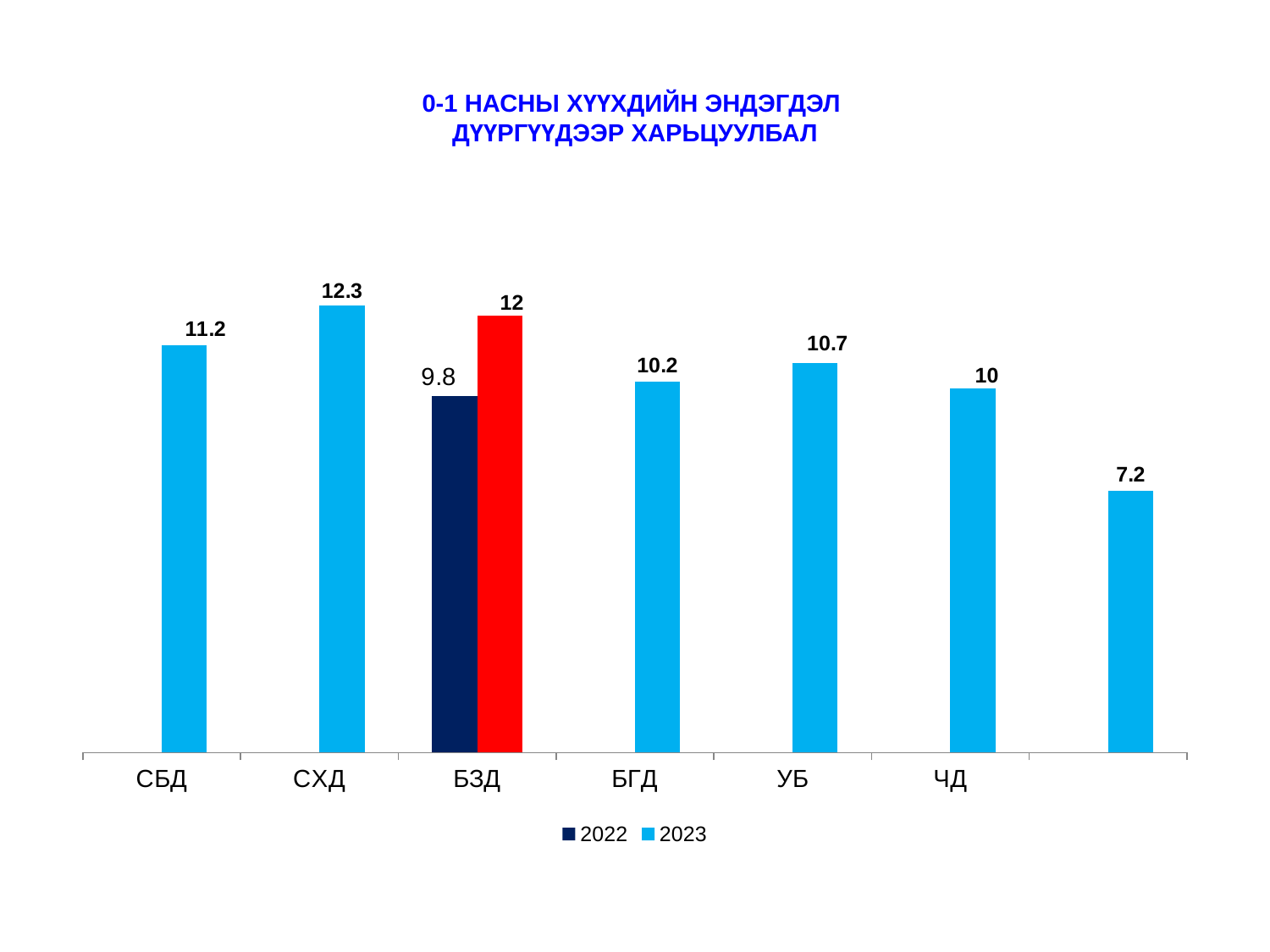
What is the difference between the 2023 and 2022 values for БЗД? 2.2 What is the 2023 value for ЧД? 10 Which is larger, the 2023 value for СБД or the 2023 value for УБ? СБД What is the 2022 value for БЗД? 9.8 What is the 2023 value for БЗД? 12 What kind of chart is shown on the slide? Bar chart What is the 2023 value for СБД? 11.2 What is the difference between the 2023 values for СХД and БГД? 2.1 Which labeled district has the highest 2023 value? СХД What is the 2023 value for УБ? 10.7 What is the 2023 value for СХД? 12.3 How many series does the legend list? 2